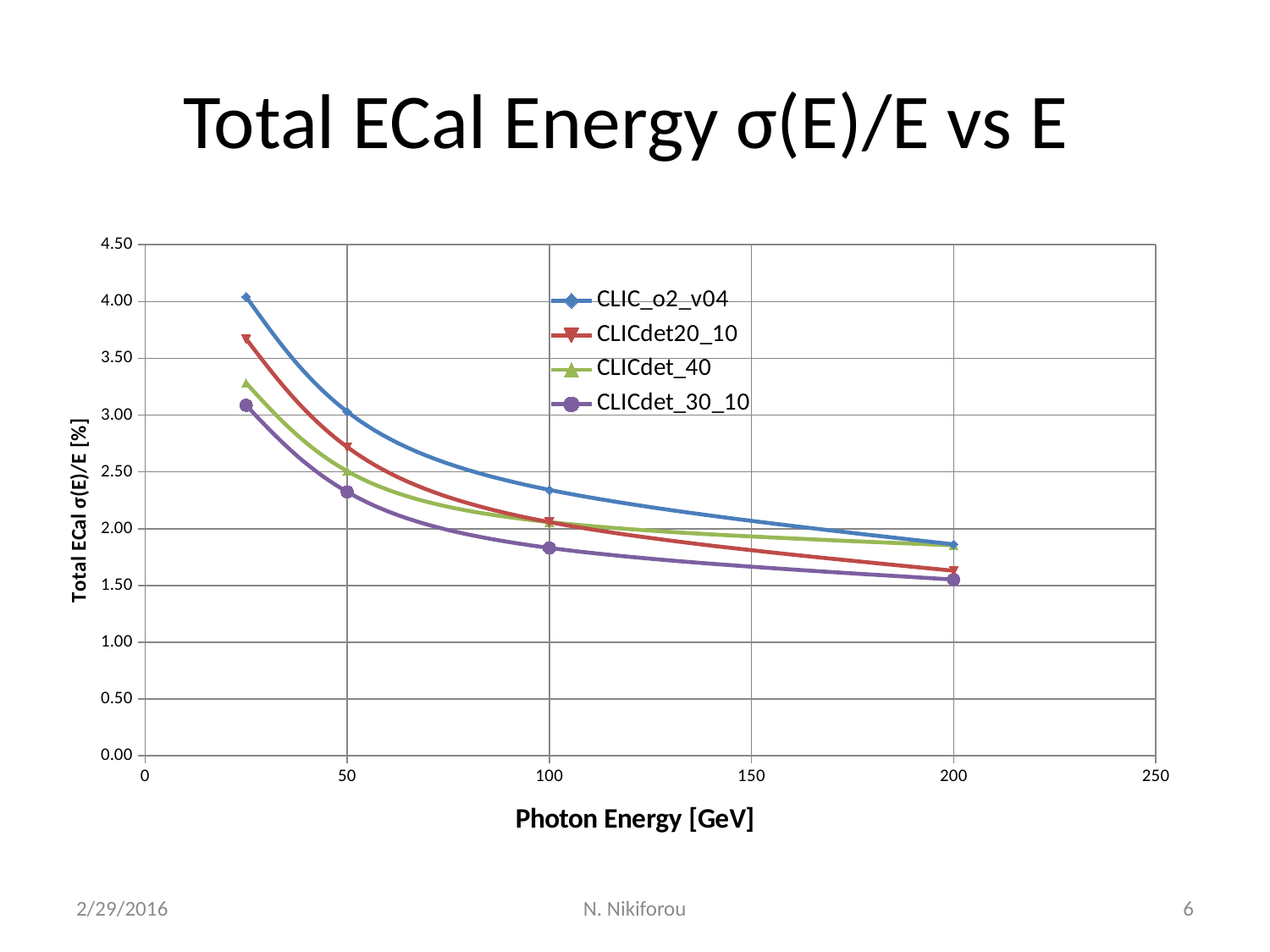
How many photon energy data points are plotted for each series? 4 What kind of chart is shown on the slide? line chart Which series has the lowest Total ECal σ(E)/E at the lowest photon energy point (25 GeV)? CLICdet_30_10 Is the value for CLIC_o2_v04 at 25 GeV greater or less than 3.50? greater Is the value for CLIC_o2_v04 at 50 GeV greater or less than 2.50? greater Is the value for CLICdet_30_10 at 200 GeV greater or less than 2.00? less Do the values of the series rise or fall as photon energy increases along the x axis? fall Which series has the highest Total ECal σ(E)/E at the lowest photon energy point (25 GeV)? CLIC_o2_v04 How many series does the legend list? 4 What is the title of the x axis? Photon Energy [GeV] At 50 GeV, which series has the larger value: CLICdet20_10 or CLICdet_40? CLICdet20_10